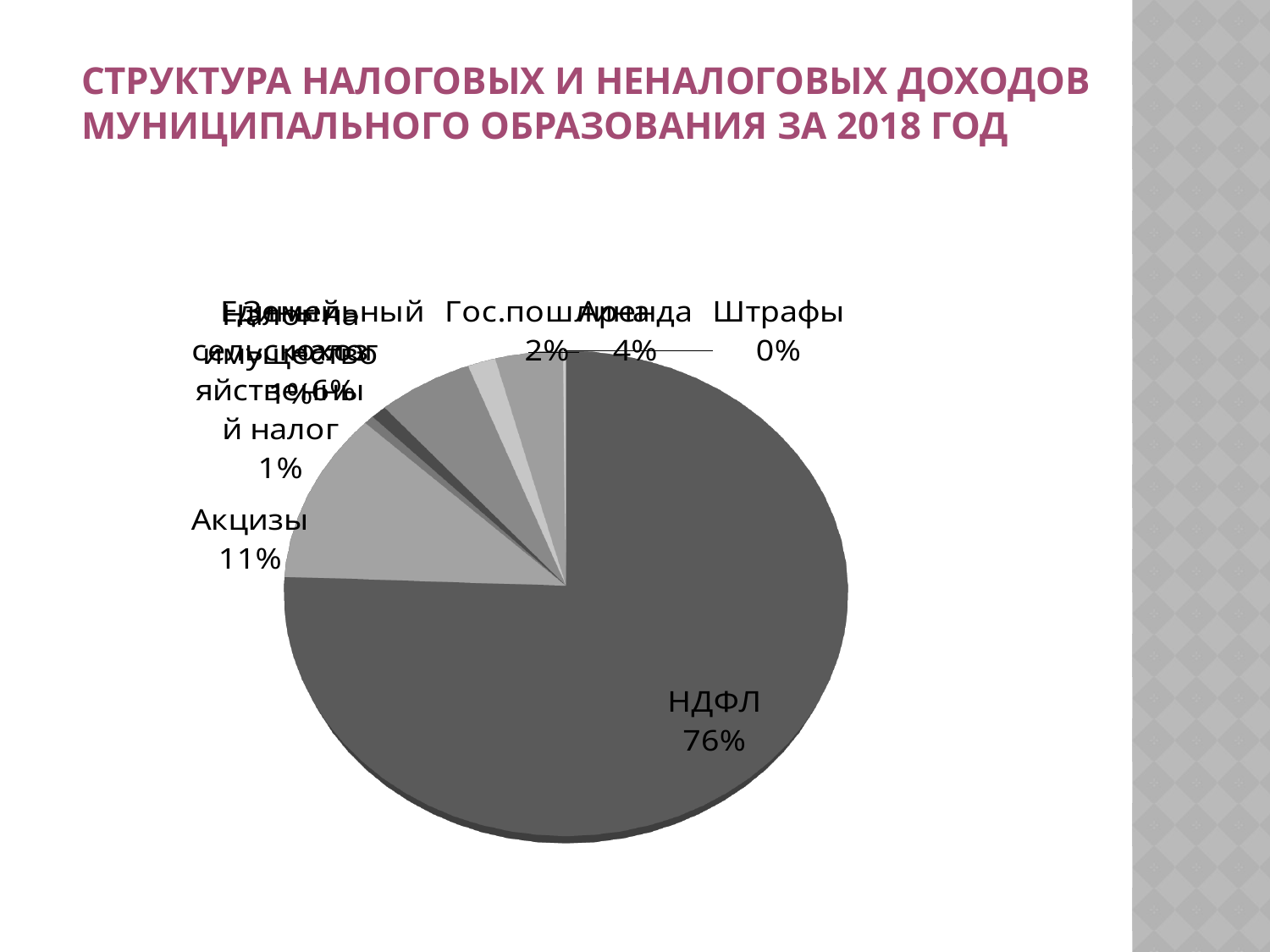
What is the value shown for Штрафы? 0% Which is larger, the share for Аренда or the share for Гос.пошлина? Аренда What is the value shown for Акцизы? 11% What year does the slide title say the revenue structure is for? 2018 What share of the pie does НДФЛ have? 76% Which category has the largest share of the pie? НДФЛ Which is larger, the share for Акцизы or the share for Аренда? Акцизы Which category has the smallest share of the pie? Штрафы What is the value shown for Аренда? 4% What is the value shown for Гос.пошлина? 2% What is the difference in percentage points between the share for НДФЛ and the share for Акцизы? 65 What kind of chart is shown on the slide? pie chart